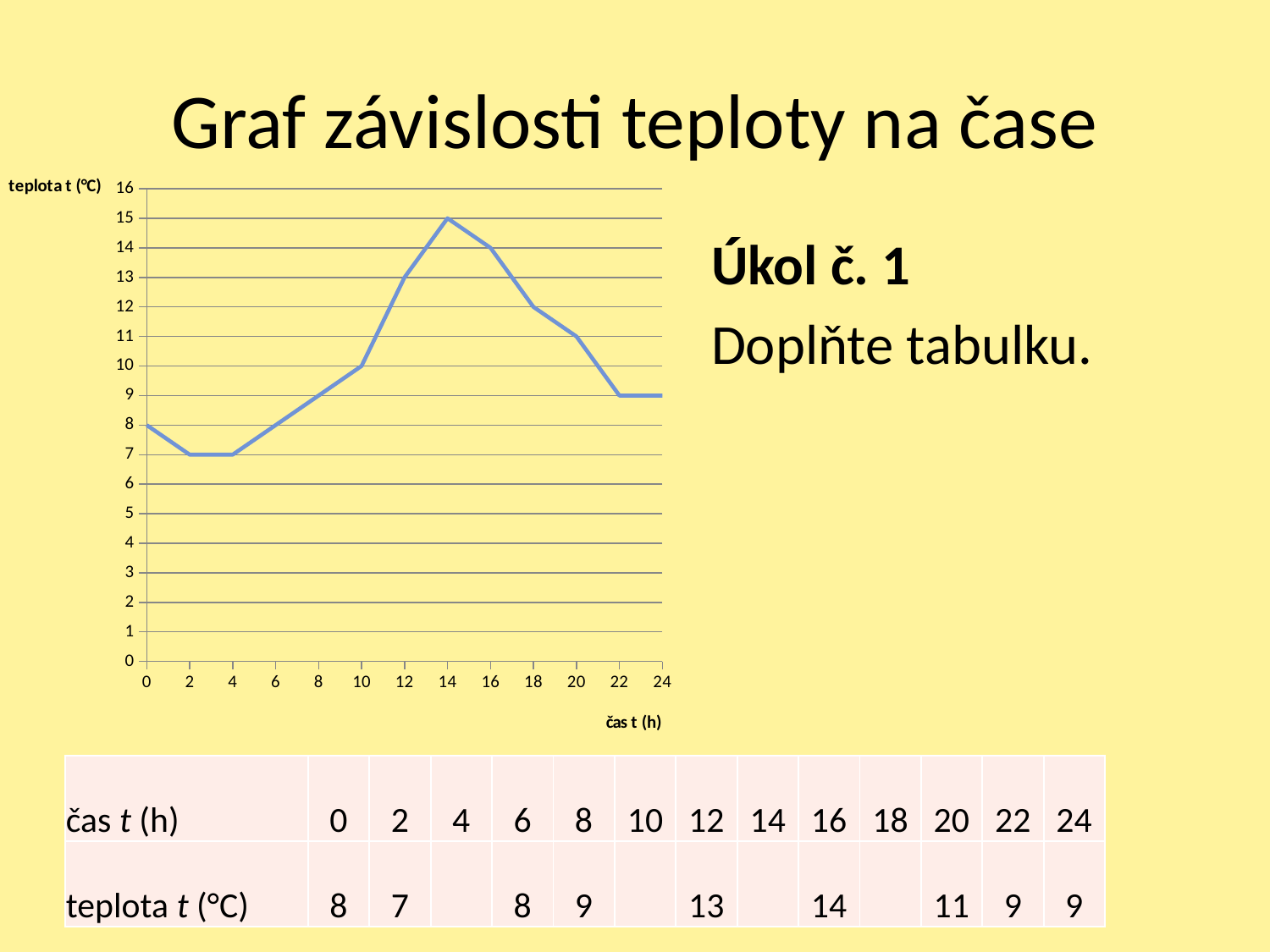
What is the temperature at time 10 h according to the chart? 10 What is the temperature at time 14 h according to the chart? 15 Is the temperature at 22 h greater or less than 10? less What is the lowest temperature shown on the chart? 7 What is the temperature at time 18 h according to the chart? 12 At which time is the temperature highest? 14 Does the temperature rise or fall between 4 h and 14 h? rise What kind of chart is shown on the slide? line chart Which is higher, the temperature at 12 h or at 20 h? 12 h What is the difference between the temperature at 14 h and the temperature at 0 h? 7 What is the label of the vertical axis of the chart? teplota t (°C) What is the temperature at time 4 h according to the chart? 7